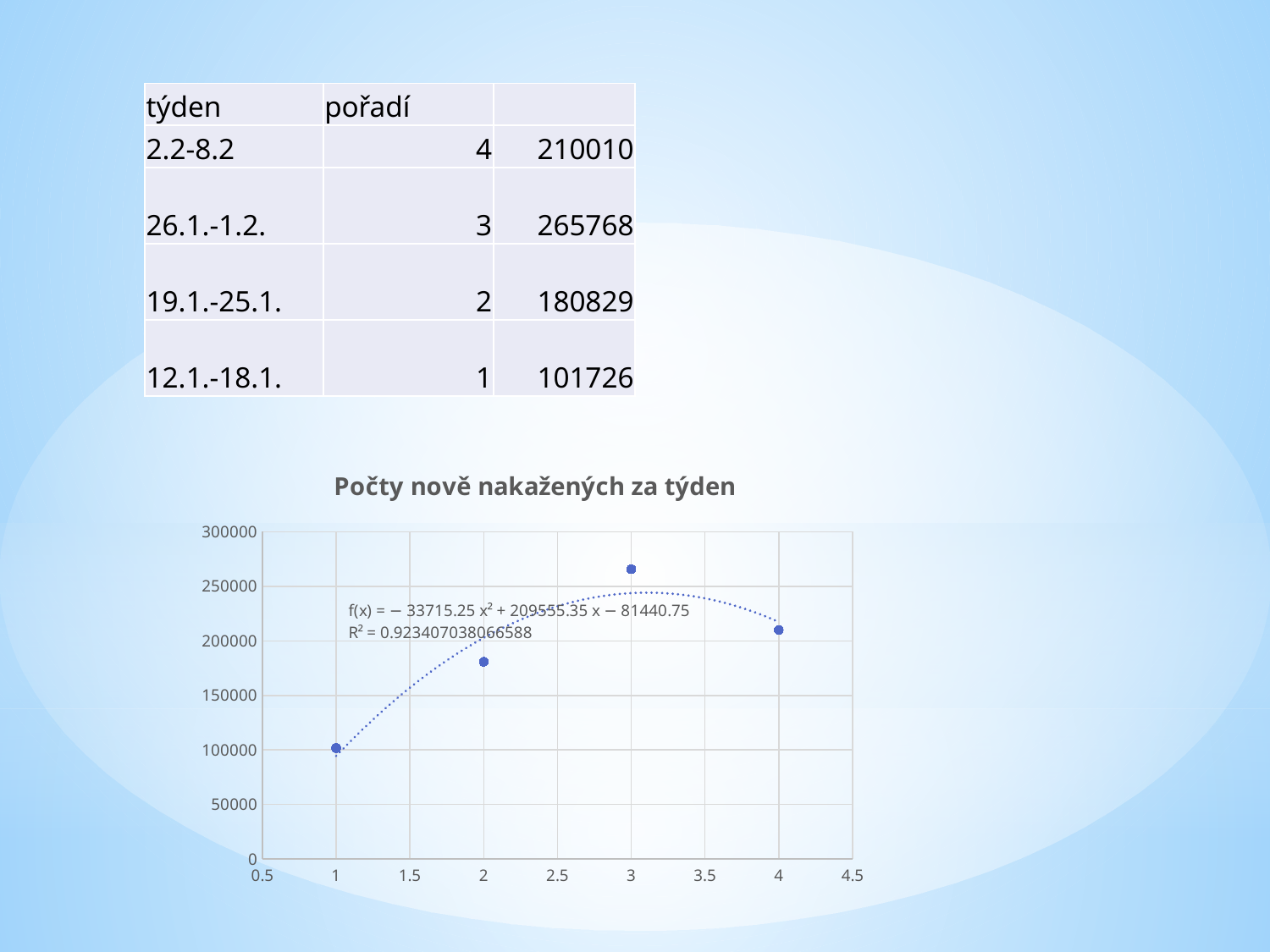
What kind of chart is shown on the slide? scatter chart Is the plotted value at x = 1 greater or less than 150000? less What R² value is shown for the trendline in the chart? 0.923407038066588 What is the title of the chart? Počty nově nakažených za týden How do the plotted values change from x = 1 to x = 4? rise from 1 to 3, then fall at 4 Which has the larger plotted value, x = 2 or x = 4? x = 4 At which x value (pořadí) is the plotted value lowest? 1 Is the plotted value at x = 3 greater or less than 250000? greater How many data points are plotted in the chart? 4 At which x value (pořadí) is the plotted value highest? 3 According to the table, what is the number of newly infected for the week 26.1.-1.2. (pořadí 3)? 265768 Is the plotted value at x = 2 greater or less than 200000? less